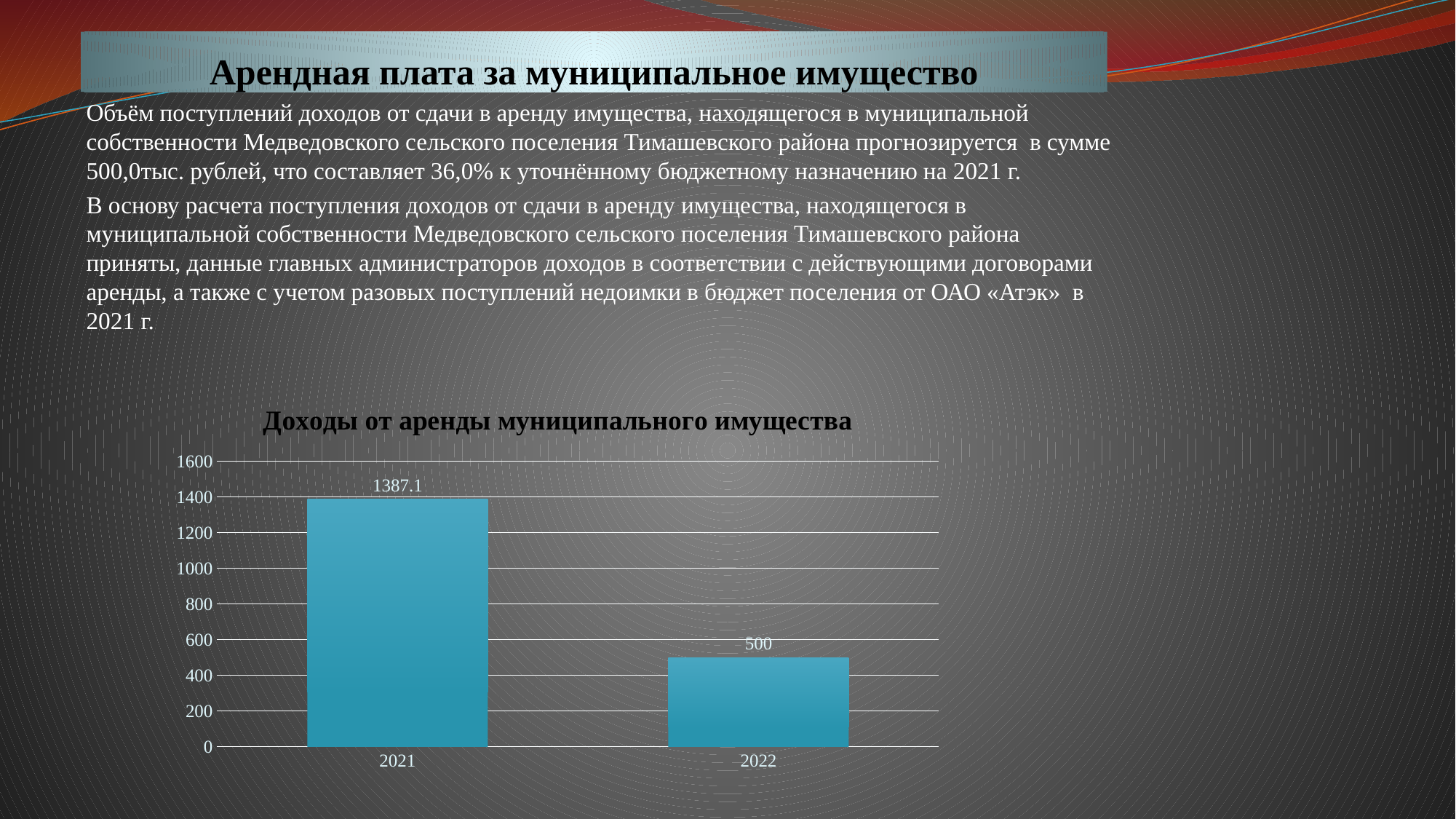
Is the value for 2021 greater or less than 1200? greater What is the value for 2022 in the chart? 500 Is the value for 2022 greater or less than 800? less How many categories are shown on the x axis of the chart? 2 Which year has the highest value in the chart? 2021 Which year has the lowest value in the chart? 2022 What is the value for 2021 in the chart? 1387.1 What is the title of the chart? Доходы от аренды муниципального имущества Which is larger, the value for 2021 or the value for 2022? 2021 Do the values rise or fall from 2021 to 2022? fall What kind of chart is shown on the slide? bar chart What is the difference between the values for 2021 and 2022? 887.1